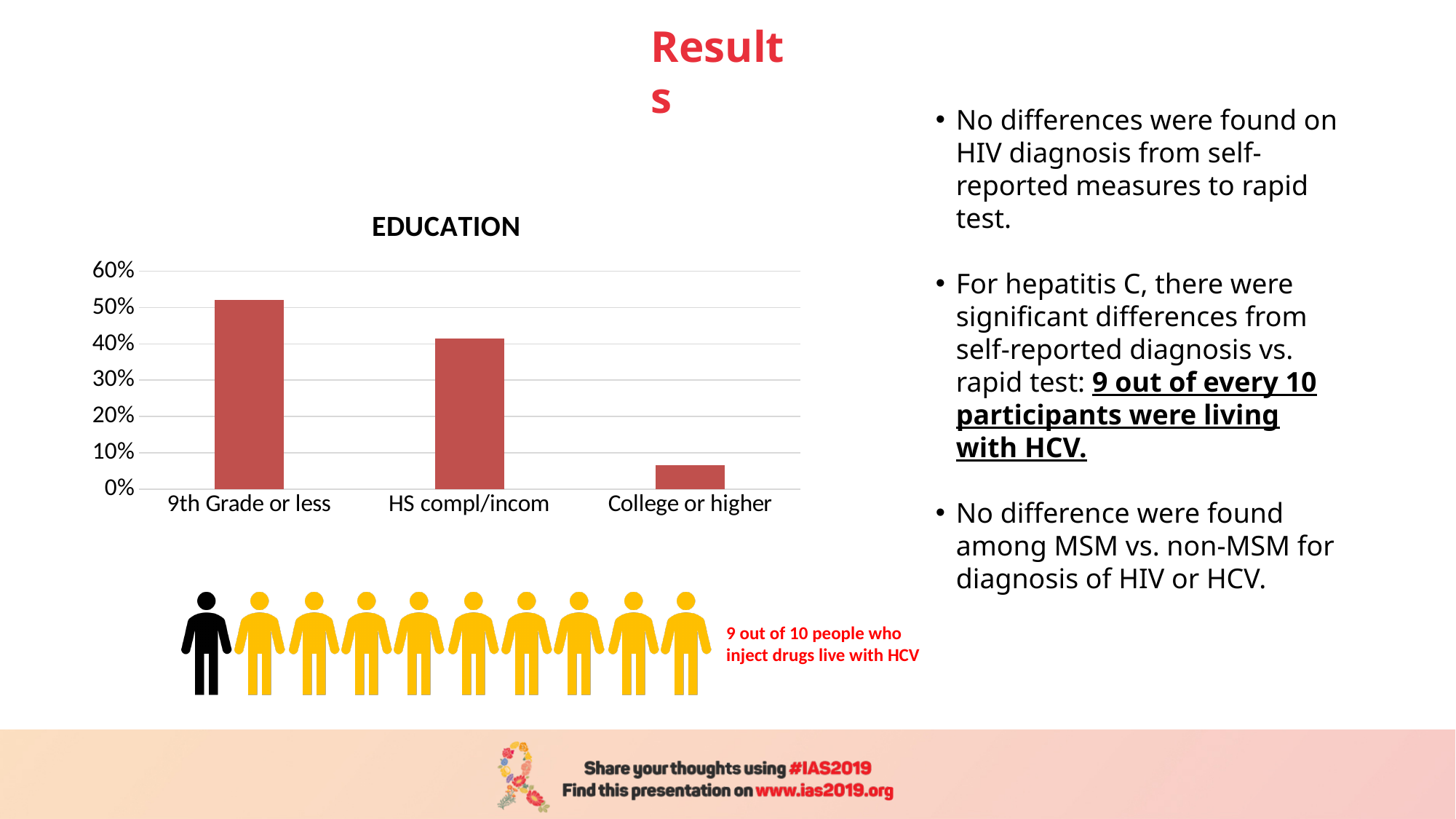
In the EDUCATION chart, is the value for HS compl/incom greater or less than 30%? greater In the EDUCATION chart, which is larger: the value for 9th Grade or less or the value for HS compl/incom? 9th Grade or less In the EDUCATION chart, is the value for HS compl/incom greater or less than 50%? less In the EDUCATION chart, is the value for College or higher greater or less than 10%? less What is the title of the bar chart on the slide? EDUCATION Do the bar values in the EDUCATION chart rise or fall from left to right along the x axis? fall Which education category has the highest value in the EDUCATION chart? 9th Grade or less What kind of chart is the EDUCATION chart? bar chart How many education categories are shown on the x axis of the EDUCATION chart? 3 In the EDUCATION chart, which is larger: the value for HS compl/incom or the value for College or higher? HS compl/incom Which education category has the lowest value in the EDUCATION chart? College or higher